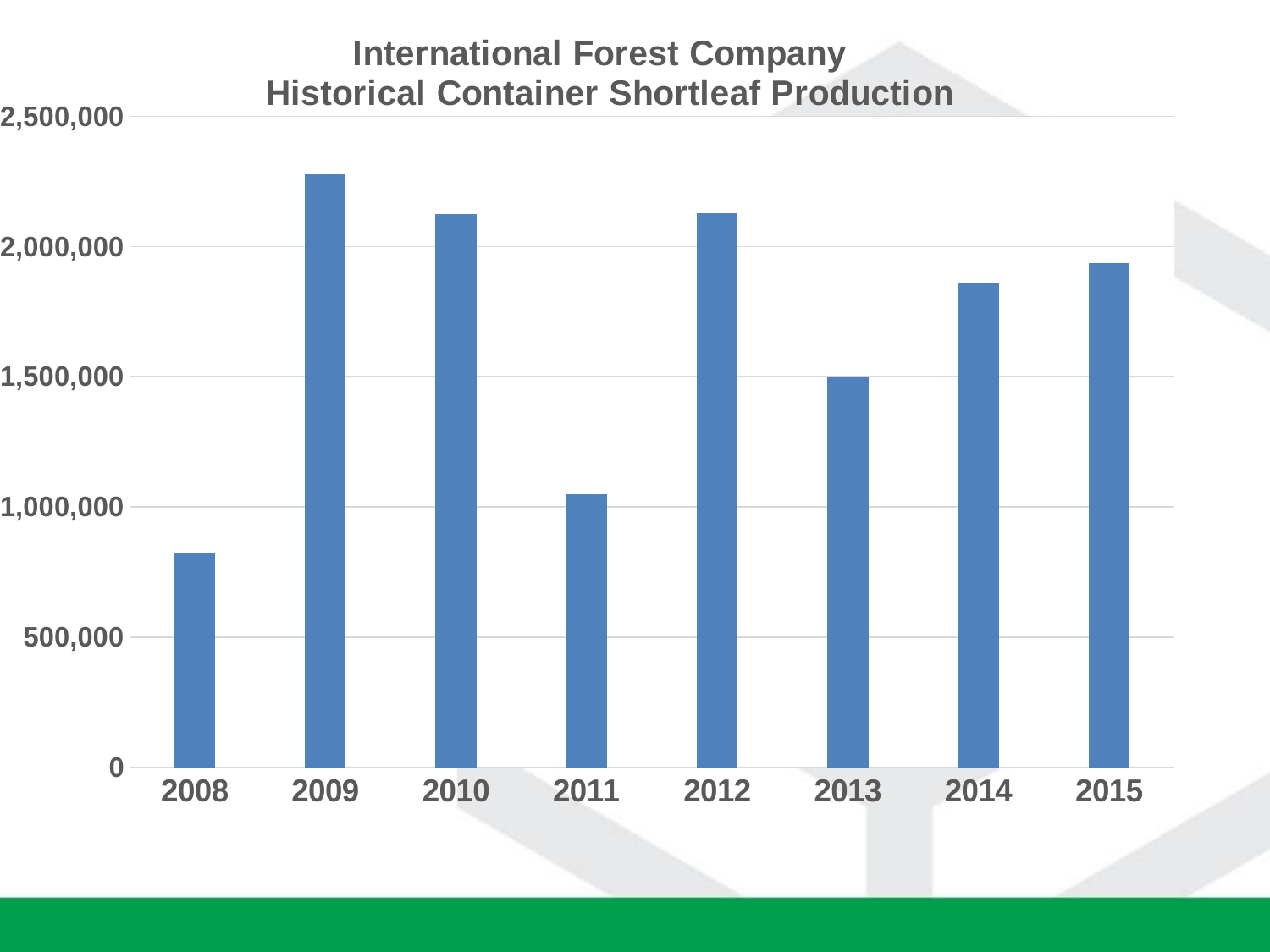
Is the value for 2014 greater or less than 2,000,000? less What kind of chart is shown on the slide? bar chart Is the value for 2008 greater or less than 1,000,000? less Do the values rise or fall from 2013 to 2015? rise Which year has the larger production, 2008 or 2011? 2011 Is the value for 2009 greater or less than 2,000,000? greater Which year has the highest container shortleaf production? 2009 Which year has the larger production, 2009 or 2010? 2009 How many years are shown on the x axis of the chart? 8 What is the title of the chart? International Forest Company Historical Container Shortleaf Production Which year has the lowest container shortleaf production? 2008